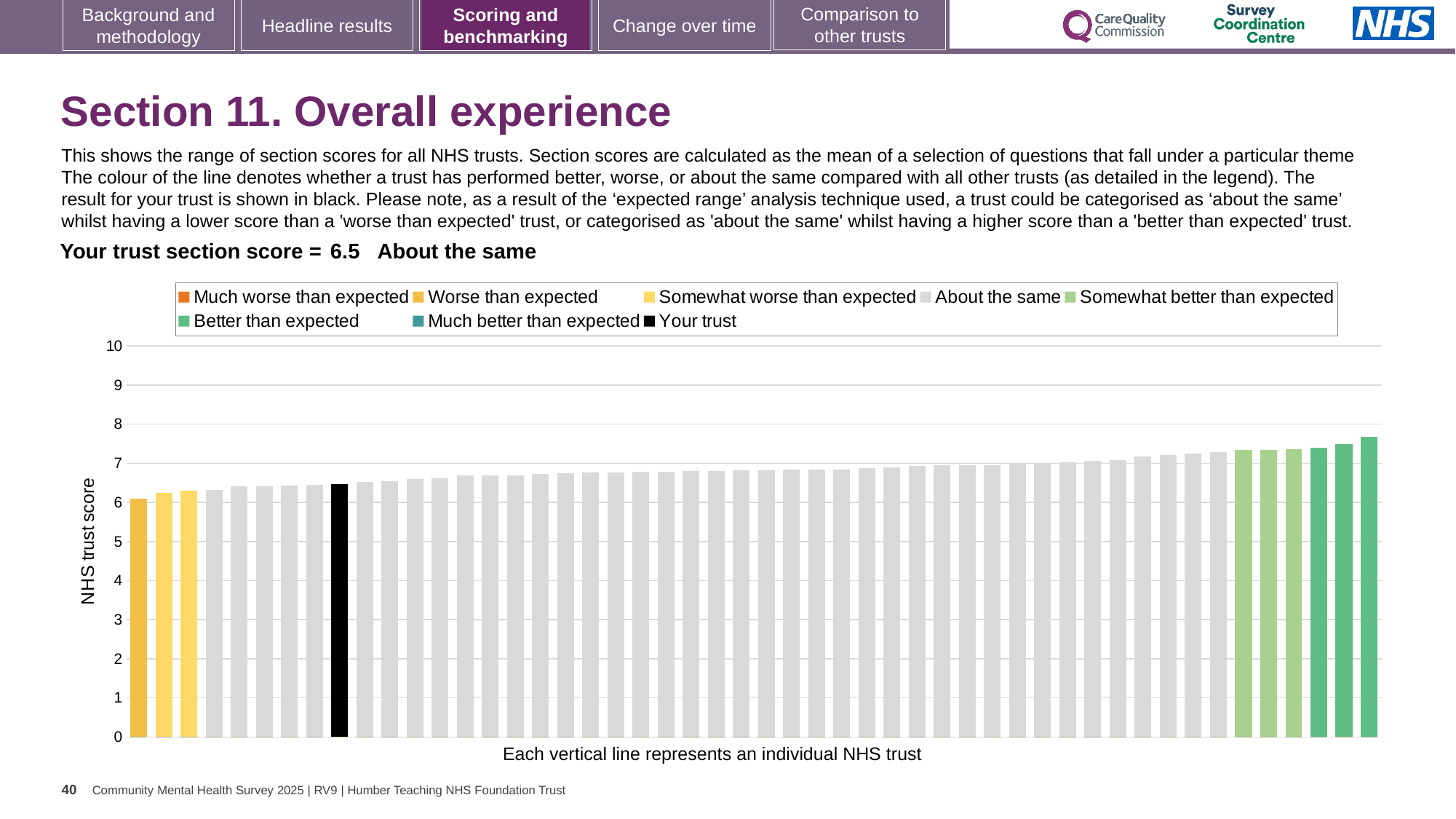
Which category is your trust placed in for this section? About the same What colour is the bar representing your trust? black What is the label on the vertical axis of the chart? NHS trust score Is the value of the leftmost bar greater or less than 7? less What is the section score for your trust shown on the slide? 6.5 Do the bar values rise or fall from left to right along the x axis? rise Is the value of the black bar (your trust) greater or less than 5? greater What kind of chart is shown on the slide? bar chart How many entries does the chart legend list? 8 Is the value of the tallest bar on the right greater or less than 7? greater